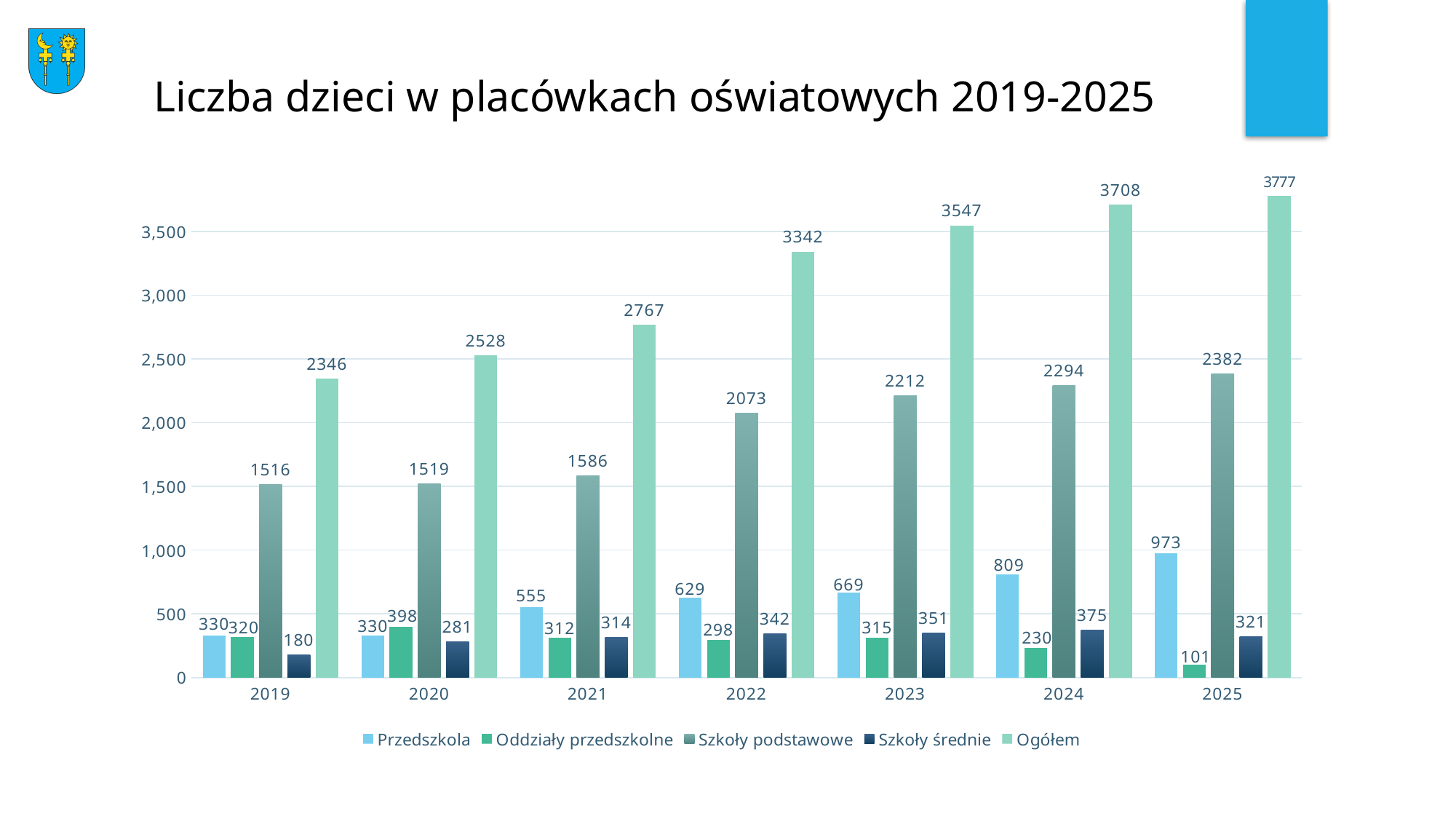
How many years are shown on the x axis? 7 What is the value for Szkoły podstawowe in 2022? 2073 What is the difference between the Ogółem values for 2025 and 2019? 1431 Do the Ogółem values rise or fall from 2019 to 2025? Rise What is the value for Ogółem in 2025? 3777 What kind of chart is shown on the slide? Bar chart What is the value for Szkoły średnie in 2019? 180 What is the value for Przedszkola in 2021? 555 In which year is the value for Oddziały przedszkolne the lowest? 2025 In which year is the value for Przedszkola the highest? 2025 Which is larger: Szkoły średnie in 2024 or Szkoły średnie in 2025? Szkoły średnie in 2024 How many series does the legend list? 5